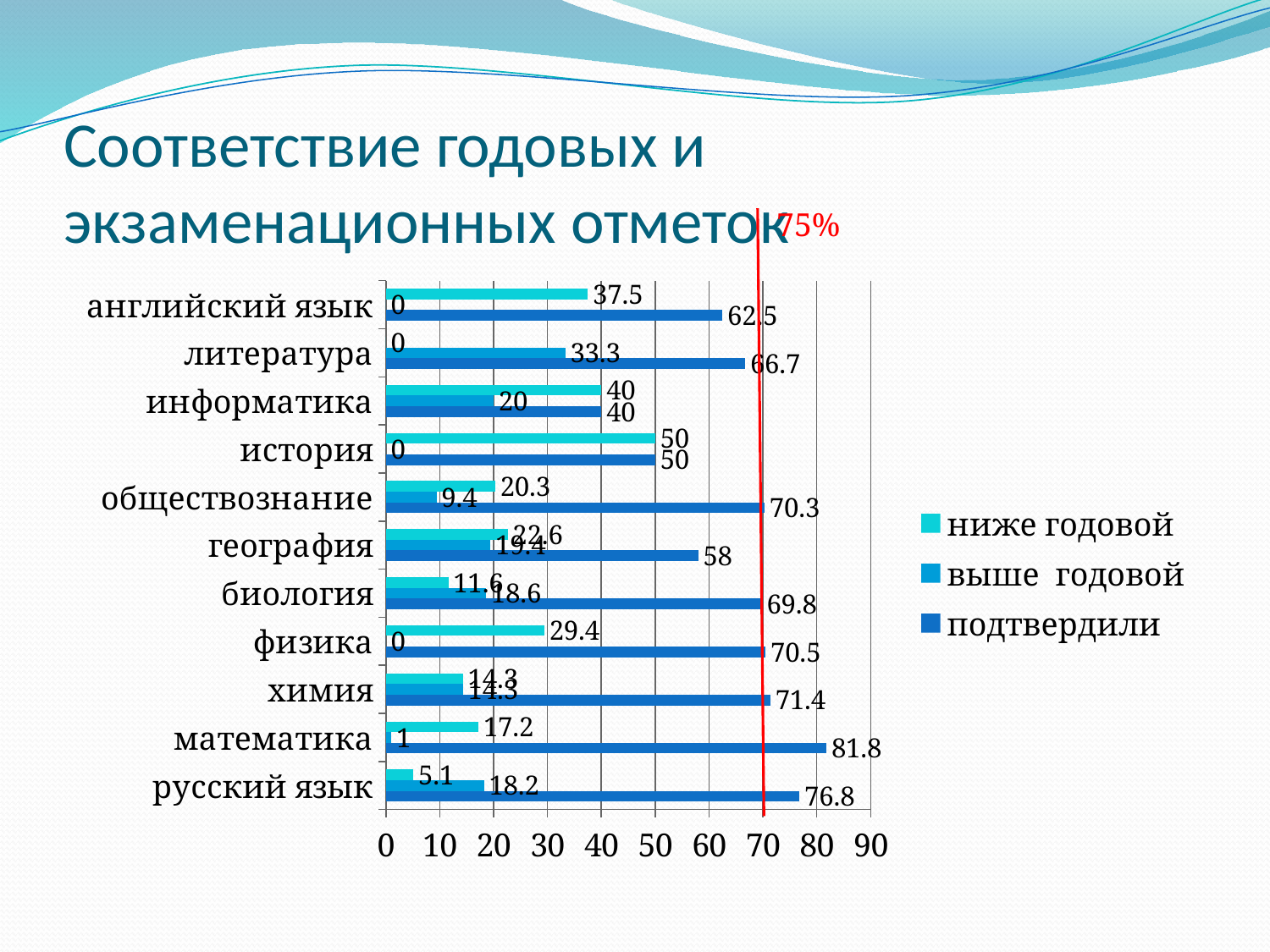
What is the value of the "подтвердили" series for математика? 81.8 How many subjects are shown on the chart? 11 Which has the larger "подтвердили" value, литература or английский язык? литература What is the value of the "подтвердили" series for русский язык? 76.8 Is the "подтвердили" value for обществознание greater or less than 60? greater What is the value of the "ниже годовой" series for английский язык? 37.5 What kind of chart is shown on the slide? bar chart What is the value of the "ниже годовой" series for физика? 29.4 Which subject has the lowest value in the "подтвердили" series? информатика Which subject has the highest value in the "подтвердили" series? математика What is the difference between the "подтвердили" values for математика and русский язык? 5 How many series does the legend list? 3